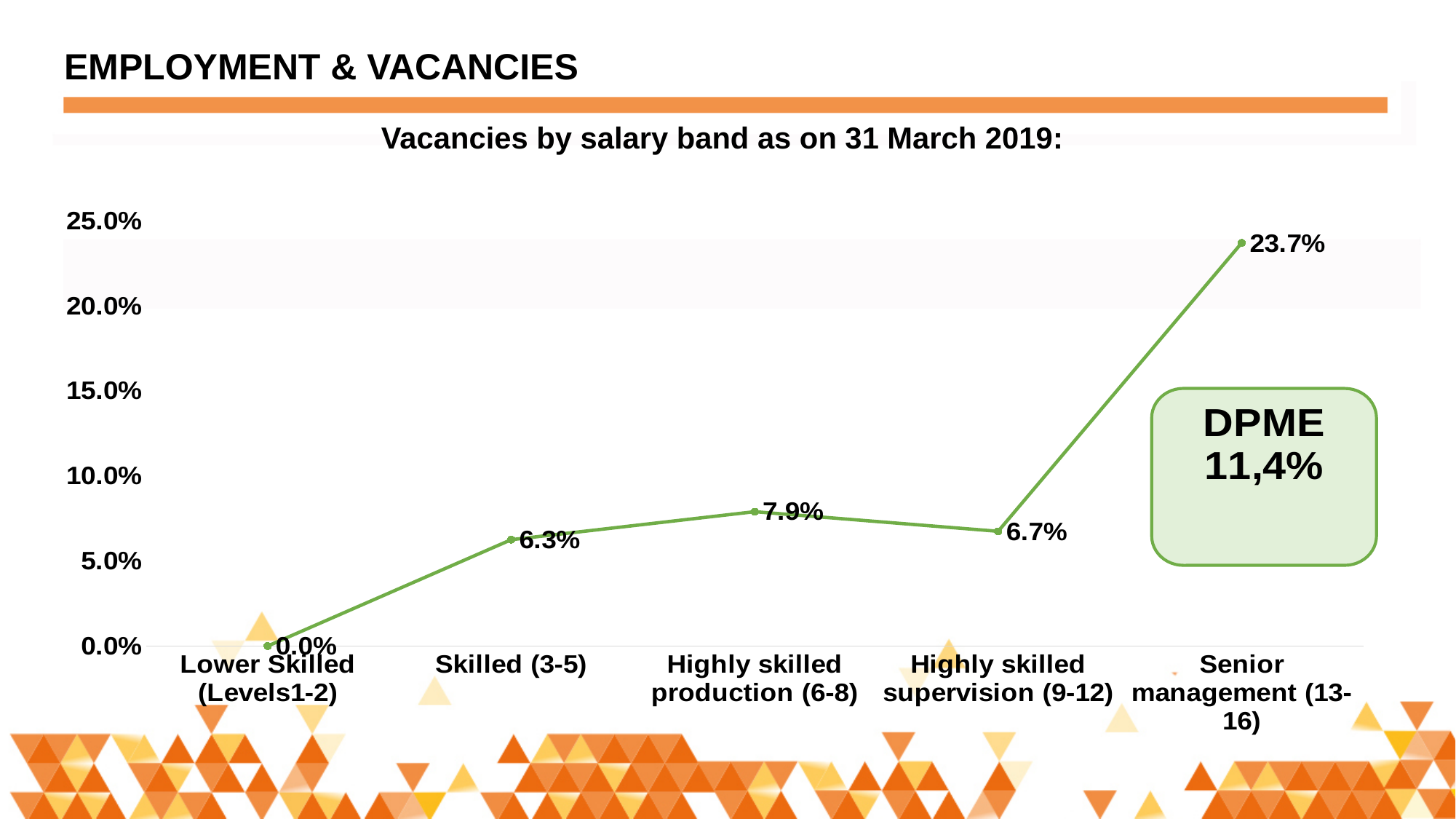
What is the vacancy rate for Skilled (3-5)? 6.3% What is the title of the chart? Vacancies by salary band as on 31 March 2019: What is the difference between the vacancy rates for Senior management (13-16) and Highly skilled supervision (9-12)? 17.0% Which salary band has the lowest vacancy rate? Lower Skilled (Levels1-2) Which has a higher vacancy rate, Highly skilled production (6-8) or Highly skilled supervision (9-12)? Highly skilled production (6-8) Which salary band has the highest vacancy rate? Senior management (13-16) What is the vacancy rate for Highly skilled production (6-8)? 7.9% How many salary bands are plotted on the chart? 5 What is the vacancy rate for Lower Skilled (Levels1-2)? 0.0% Is the value for Senior management (13-16) greater or less than 20.0%? greater What is the vacancy rate for Senior management (13-16)? 23.7% What kind of chart is shown on the slide? Line chart